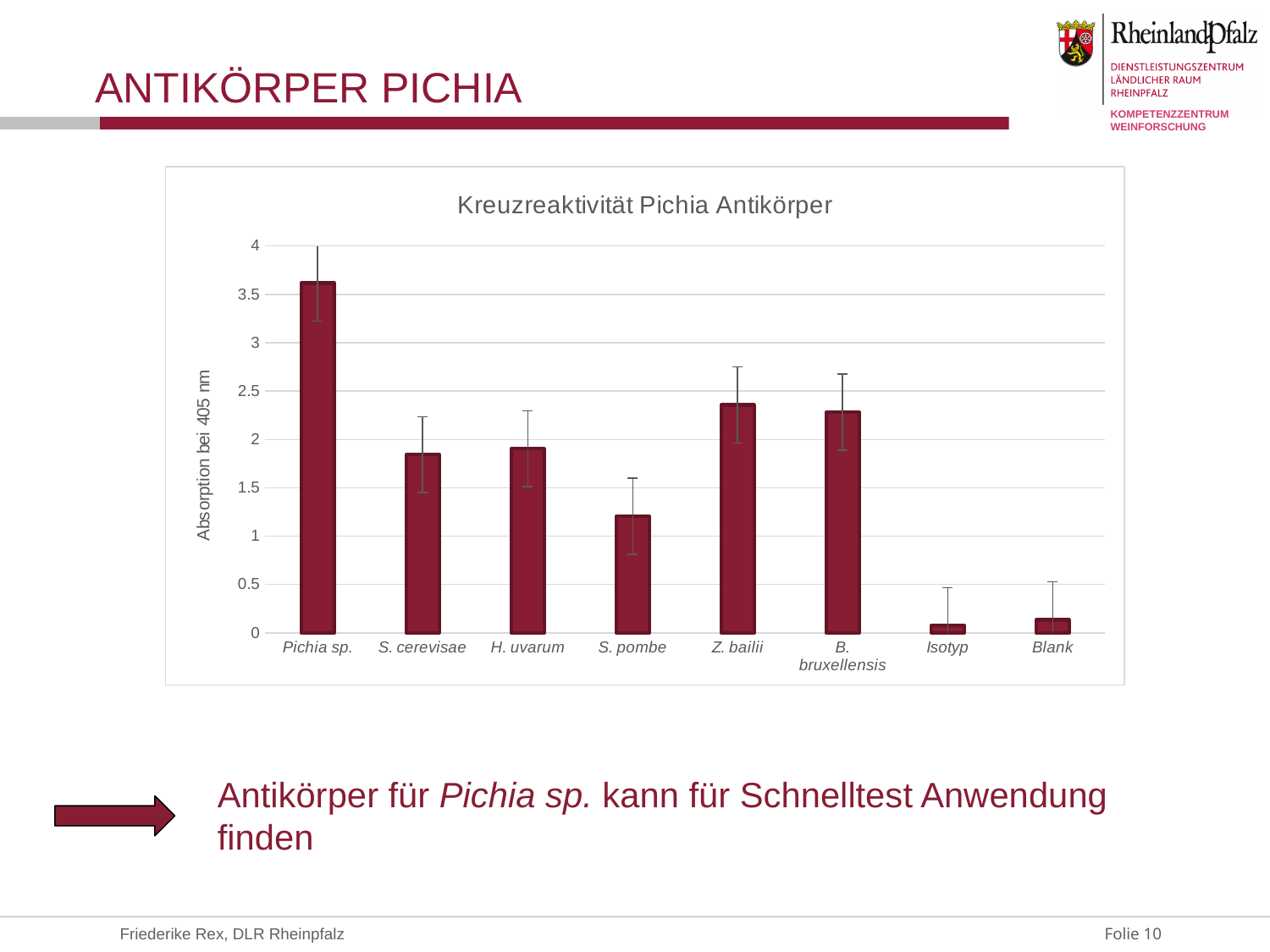
How many categories are shown on the x axis? 8 Which category has the highest absorption value? Pichia sp. Is the value for Z. bailii greater or less than 2? greater Which has the larger value, Pichia sp. or S. pombe? Pichia sp. Is the value for S. pombe greater or less than 1.5? less What kind of chart is shown on the slide? bar chart Which has the larger value, Z. bailii or S. pombe? Z. bailii Is the value for S. cerevisae greater or less than 1.5? greater What is the title of the chart? Kreuzreaktivität Pichia Antikörper What is the label of the y axis? Absorption bei 405 nm